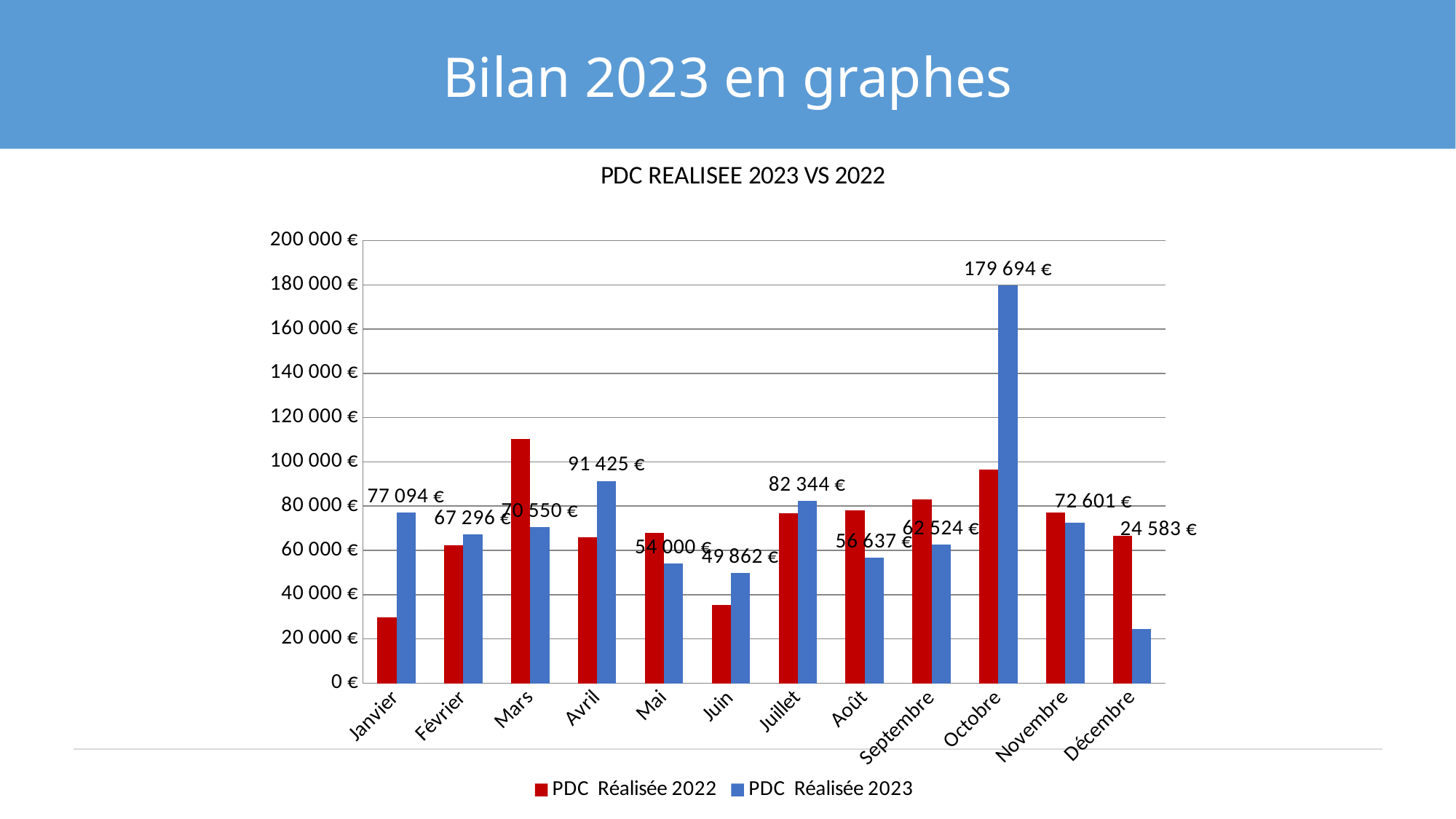
What type of chart is shown on the slide? Bar chart What is the difference between the PDC Réalisée 2023 values for Avril and Mai? 37 425 € Is the PDC Réalisée 2022 value for Janvier greater or less than 40 000 €? less Which month has the lowest PDC Réalisée 2023 value? Décembre What is the PDC Réalisée 2023 value for Décembre? 24 583 € What is the PDC Réalisée 2023 value for Octobre? 179 694 € What is the difference between the PDC Réalisée 2023 values for Octobre and Décembre? 155 111 € In Mars, which series has the larger value, PDC Réalisée 2022 or PDC Réalisée 2023? PDC Réalisée 2022 How many months are shown on the x axis? 12 Which month has the highest PDC Réalisée 2023 value? Octobre Is the PDC Réalisée 2022 value for Mars greater or less than 100 000 €? greater What is the PDC Réalisée 2023 value for Avril? 91 425 €